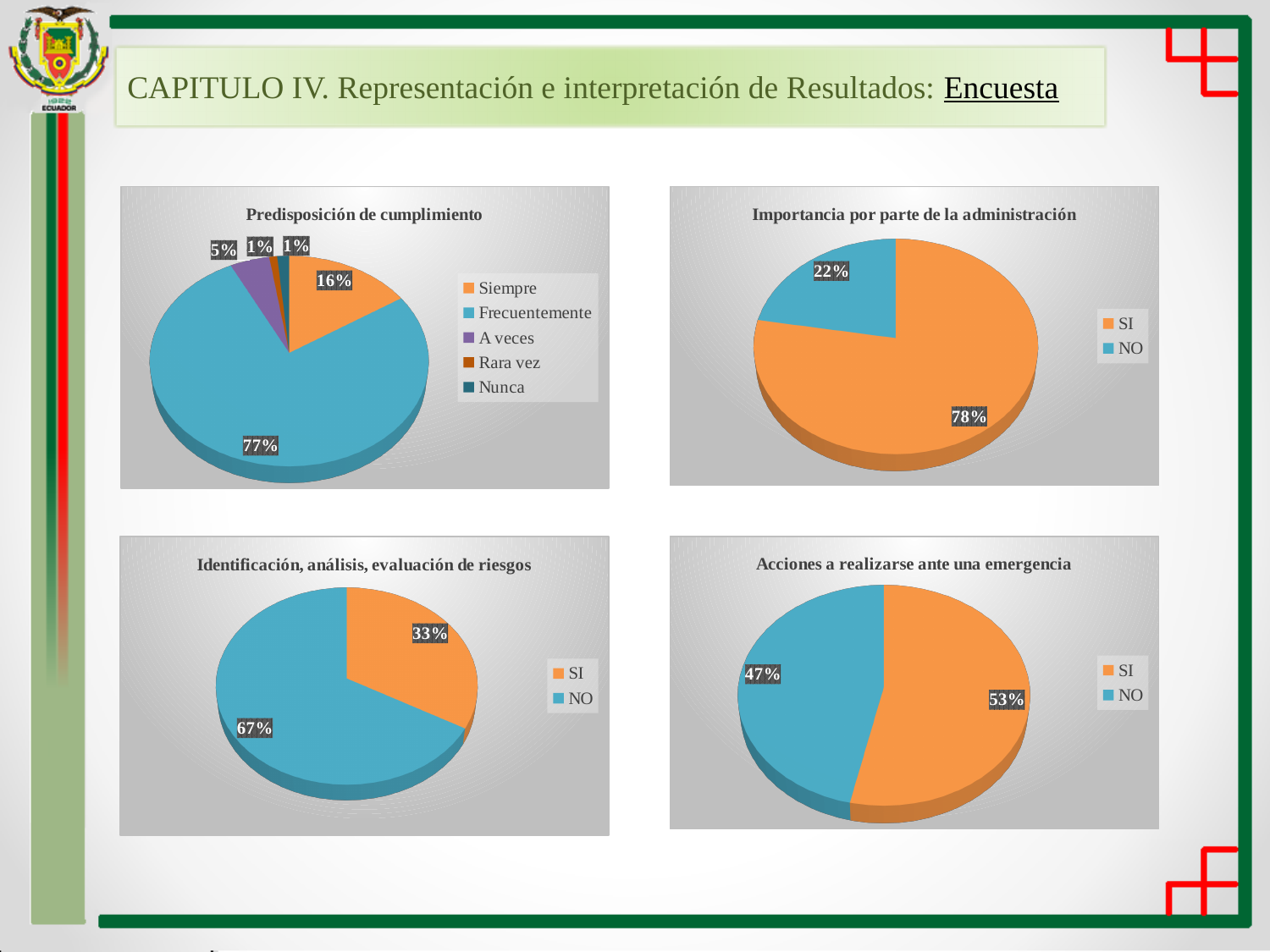
In the chart titled "Predisposición de cumplimiento", what is the value for Siempre? 16% In the chart titled "Acciones a realizarse ante una emergencia", what share does SI have? 53% In the chart titled "Identificación, análisis, evaluación de riesgos", what is the value for SI? 33% In the chart titled "Predisposición de cumplimiento", what is the difference between Frecuentemente and Siempre? 61% In the chart titled "Identificación, análisis, evaluación de riesgos", which is larger, SI or NO? NO In the chart titled "Predisposición de cumplimiento", what share does Frecuentemente have? 77% In the chart titled "Importancia por parte de la administración", what share does SI have? 78% In the chart titled "Acciones a realizarse ante una emergencia", what is the difference between SI and NO? 6% In the chart titled "Predisposición de cumplimiento", how many categories does the legend list? 5 In the chart titled "Importancia por parte de la administración", what is the value for NO? 22% What kind of chart is the one titled "Acciones a realizarse ante una emergencia"? Pie chart In the chart titled "Predisposición de cumplimiento", which category has the largest slice? Frecuentemente